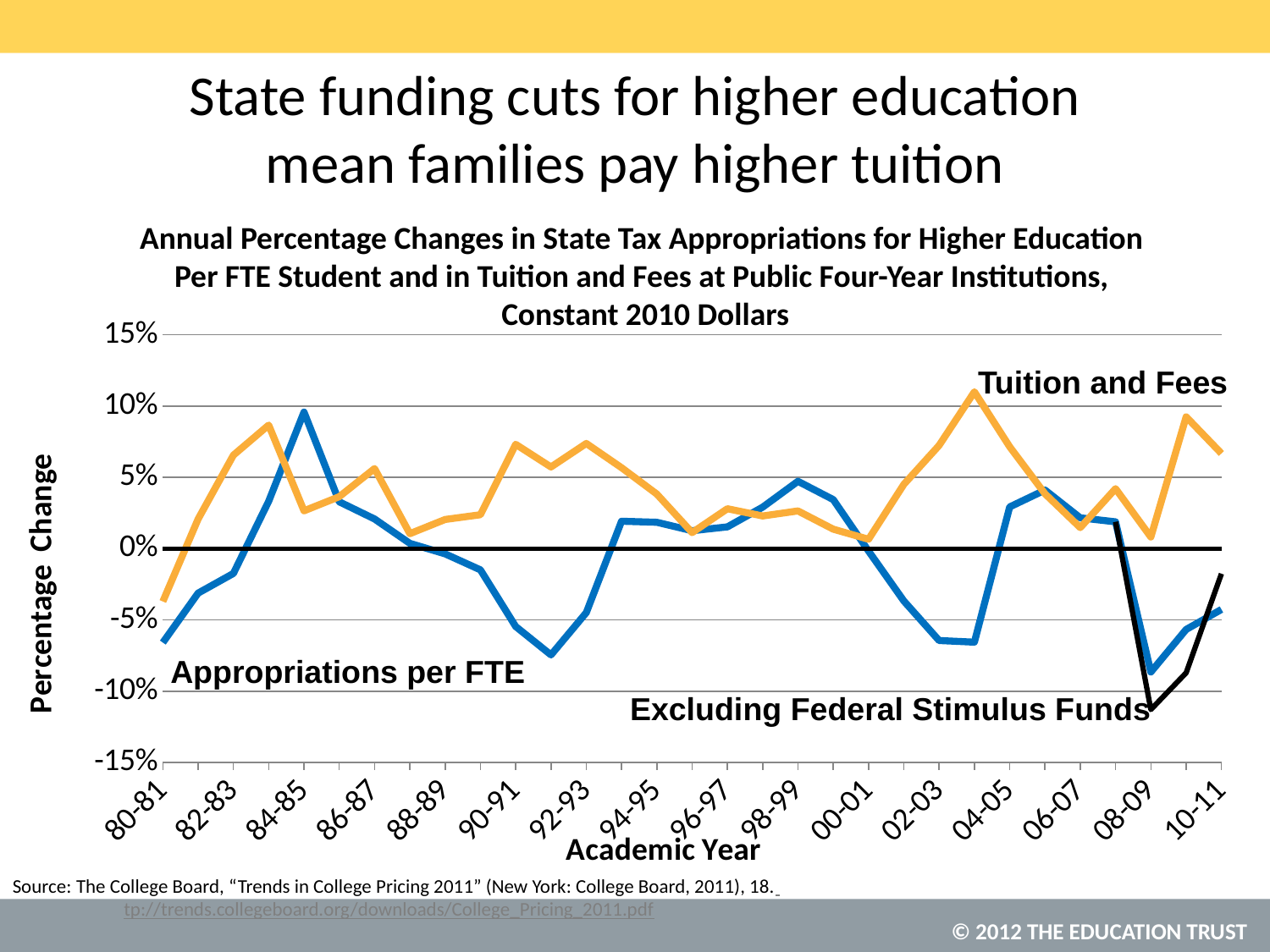
Is the value for Tuition and Fees in 80-81 greater or less than 0%? less Is the value for Appropriations per FTE in 84-85 greater or less than 5%? greater Is the value for Appropriations per FTE in 08-09 greater or less than -5%? less How many data series are plotted on the chart? 3 What kind of chart is shown on the slide? line chart What is the title of the y axis? Percentage Change Does the Appropriations per FTE line rise or fall from 80-81 to 84-85? rise In 08-09, which series has the higher value: Tuition and Fees or Appropriations per FTE? Tuition and Fees How many academic year labels are shown on the x axis? 16